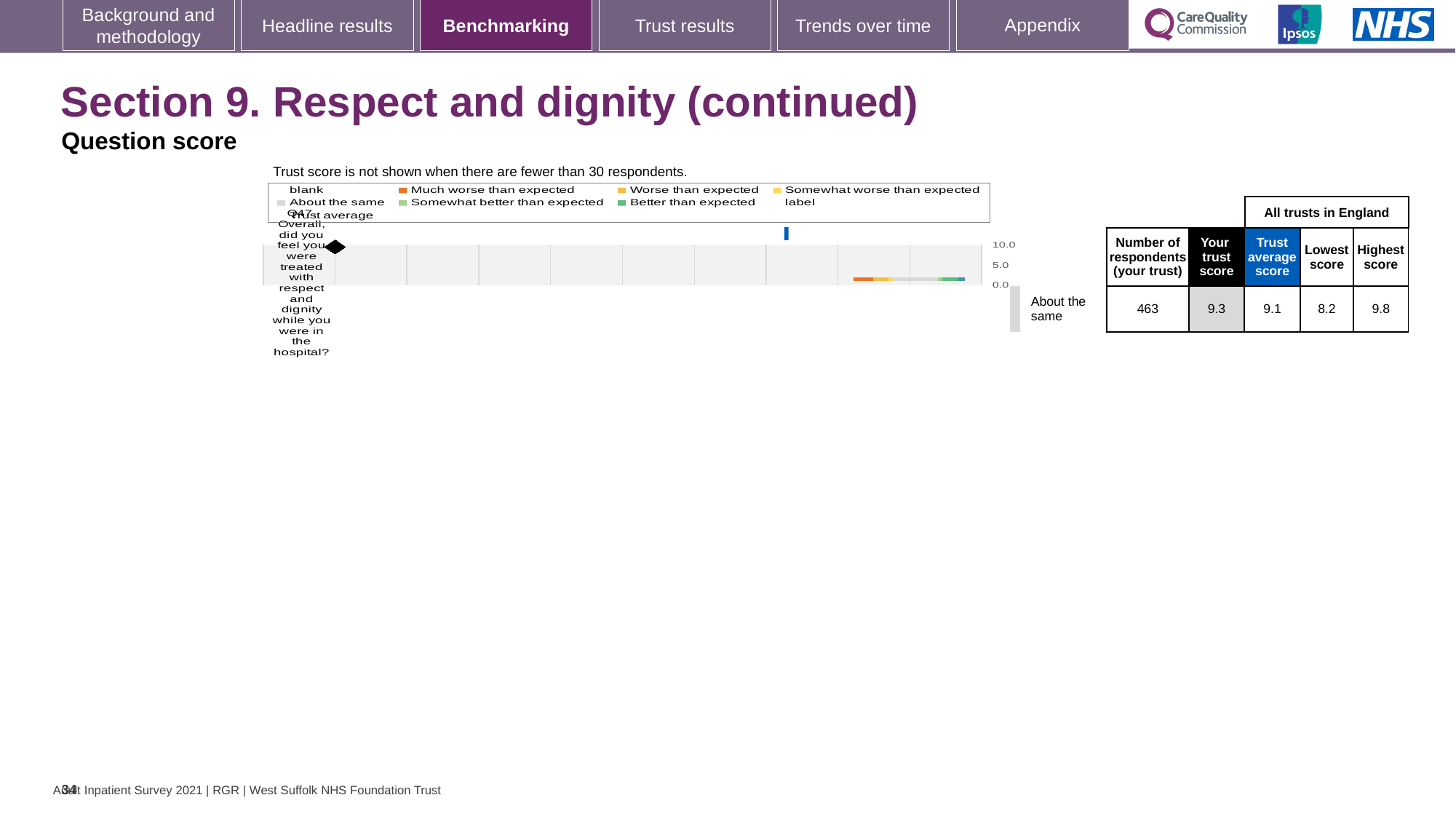
What benchmark category is your trust placed in for Q47? About the same What is the highest score among all trusts in England for Q47? 9.8 What is your trust score for Q47? 9.3 Below how many respondents is the trust score not shown? 30 By how much does your trust score exceed the trust average score for Q47? 0.2 How many respondents from your trust are shown for Q47? 463 What is the difference between the highest score and the lowest score for Q47? 1.6 What is the trust average score across all trusts in England for Q47? 9.1 Which is larger for Q47: your trust score or the trust average score? Your trust score What colour represents 'Much worse than expected' in the chart legend? Orange What is the lowest score among all trusts in England for Q47? 8.2